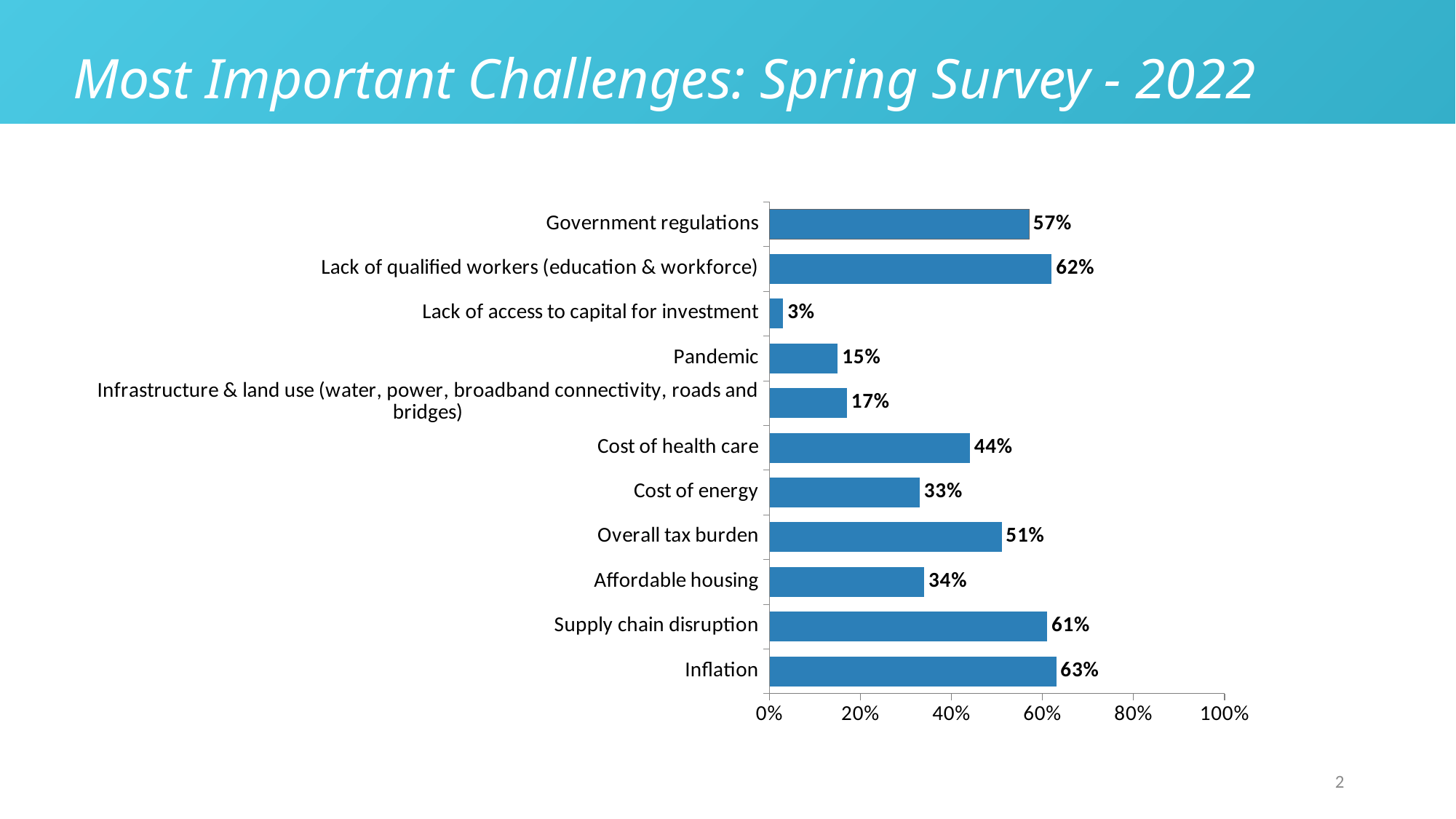
Which challenge has the lowest percentage? Lack of access to capital for investment Which is larger, the value for Overall tax burden or the value for Affordable housing? Overall tax burden How many challenges are shown in the chart? 11 Is the value for Supply chain disruption greater or less than 40%? greater What is the value for Lack of access to capital for investment? 3% What is the difference between the values for Lack of qualified workers (education & workforce) and Government regulations? 5% What percentage of respondents cited Inflation as a most important challenge? 63% Which challenge has the highest percentage? Inflation What kind of chart is shown on the slide? Bar chart What is the difference between the values for Cost of health care and Cost of energy? 11% What is the value for Cost of health care? 44% What is the title of the slide? Most Important Challenges: Spring Survey - 2022